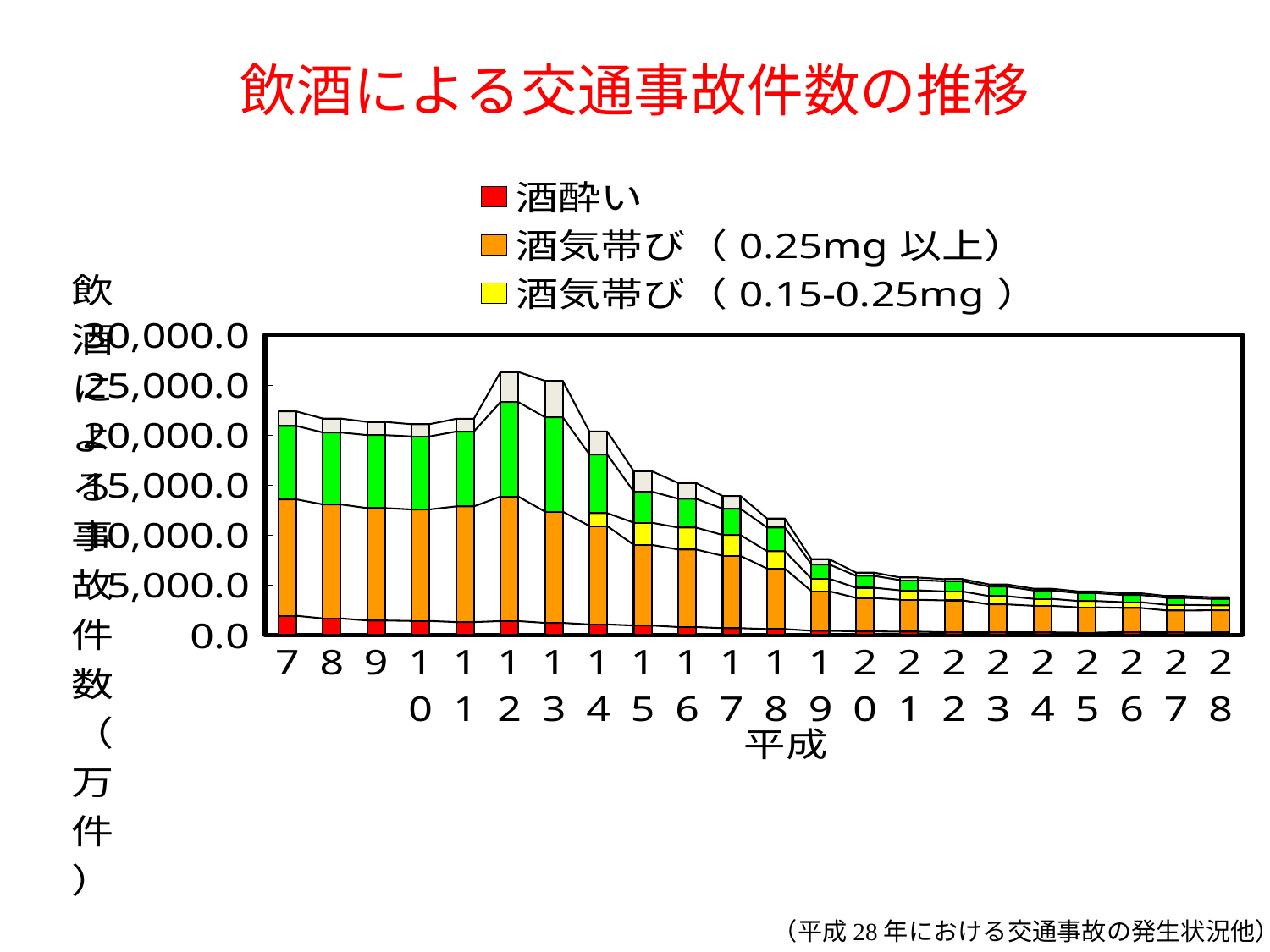
How many years (categories) are plotted along the x axis? 22 How many series does the legend list? 3 Overall, do the stacked bar totals rise or fall from 平成7 to 平成28? fall Is the total for 平成7 greater or less than 20,000.0? greater Is the total for 平成12 greater or less than 20,000.0? greater What colour does the legend use for 酒酔い? red Which has the larger total, 平成7 or 平成28? 平成7 Which year has the tallest stacked bar? 平成12 What is the title of the chart? 飲酒による交通事故件数の推移 Is the total for 平成28 greater or less than 5,000.0? less What kind of chart is shown on the slide? stacked bar chart